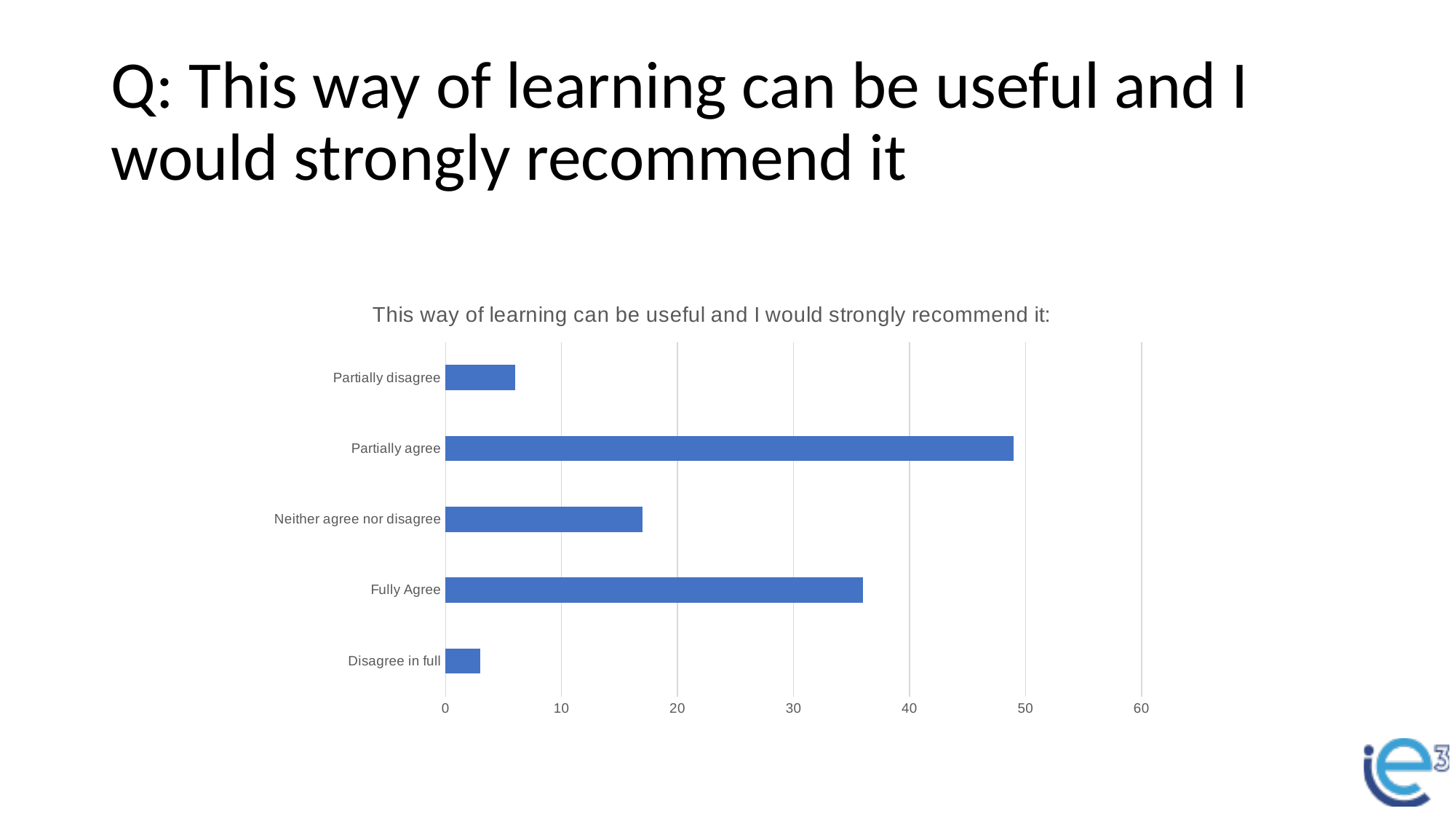
Is the value for Partially disagree greater or less than 10? less Which category has the lowest value? Disagree in full Is the value for Partially agree greater or less than 40? greater What kind of chart is shown on the slide? bar chart How many categories are shown in the chart? 5 Is the value for Fully Agree greater or less than 40? less Which is larger, the value for Partially disagree or the value for Disagree in full? Partially disagree What is the title of the chart? This way of learning can be useful and I would strongly recommend it: Which is larger, the value for Fully Agree or the value for Neither agree nor disagree? Fully Agree Which category has the highest value? Partially agree